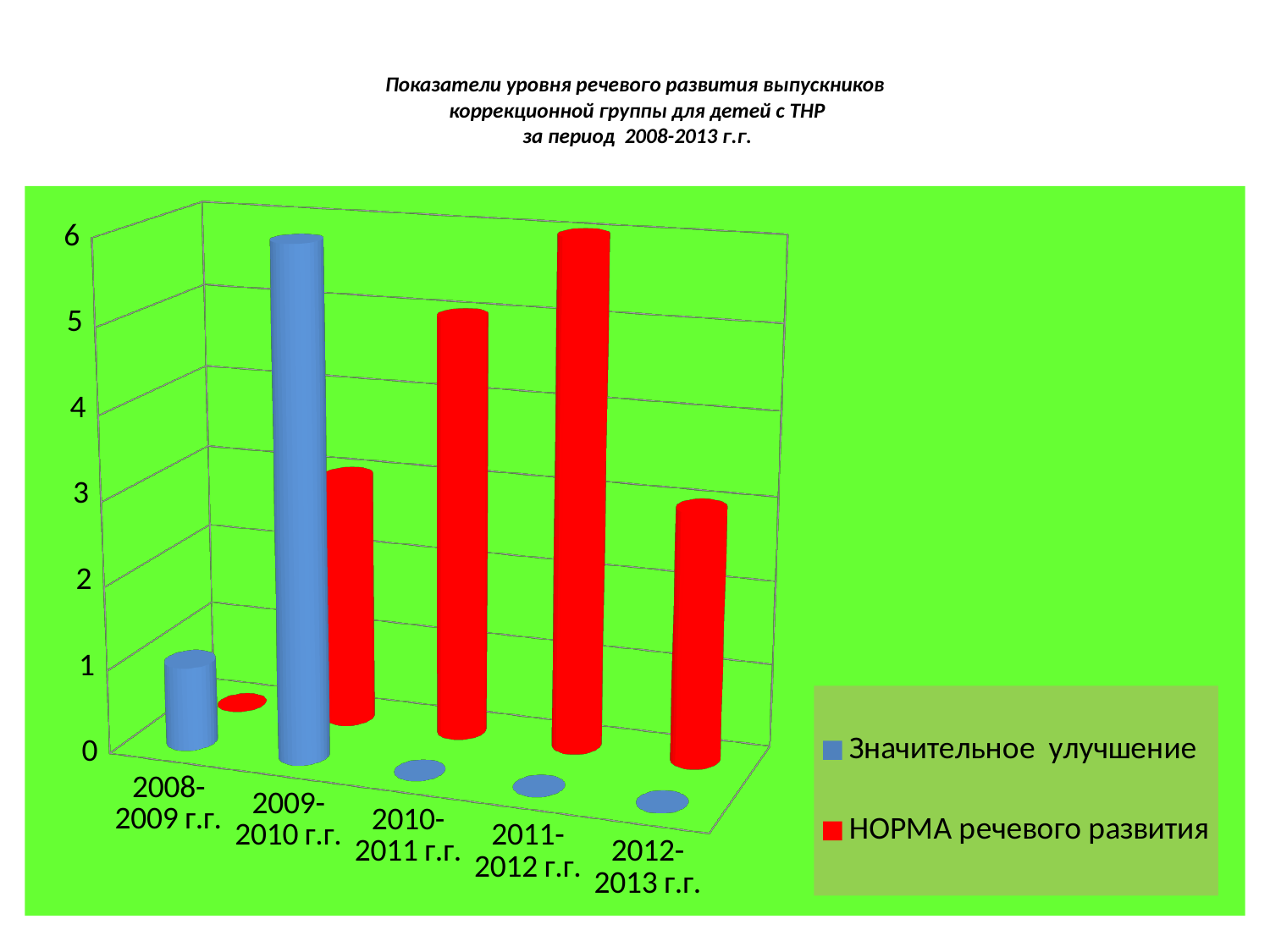
Is the value for "НОРМА речевого развития" in 2010-2011 г.г. greater or less than 3? greater How many periods (categories) are shown on the x axis? 5 Is the value for "НОРМА речевого развития" in 2012-2013 г.г. greater or less than 5? less In 2009-2010 г.г., which series has the larger value: "Значительное улучшение" or "НОРМА речевого развития"? Значительное улучшение In which period is the bar for "НОРМА речевого развития" the highest? 2011-2012 г.г. In which period is the bar for "Значительное улучшение" the highest? 2009-2010 г.г. How many series does the legend list? 2 What colour represents the series "НОРМА речевого развития" in the legend? red In which period is the bar for "НОРМА речевого развития" the lowest? 2008-2009 г.г. What kind of chart is shown on the slide? bar chart In 2010-2011 г.г., which series has the larger value: "Значительное улучшение" or "НОРМА речевого развития"? НОРМА речевого развития Is the value for "Значительное улучшение" in 2009-2010 г.г. greater or less than 4? greater